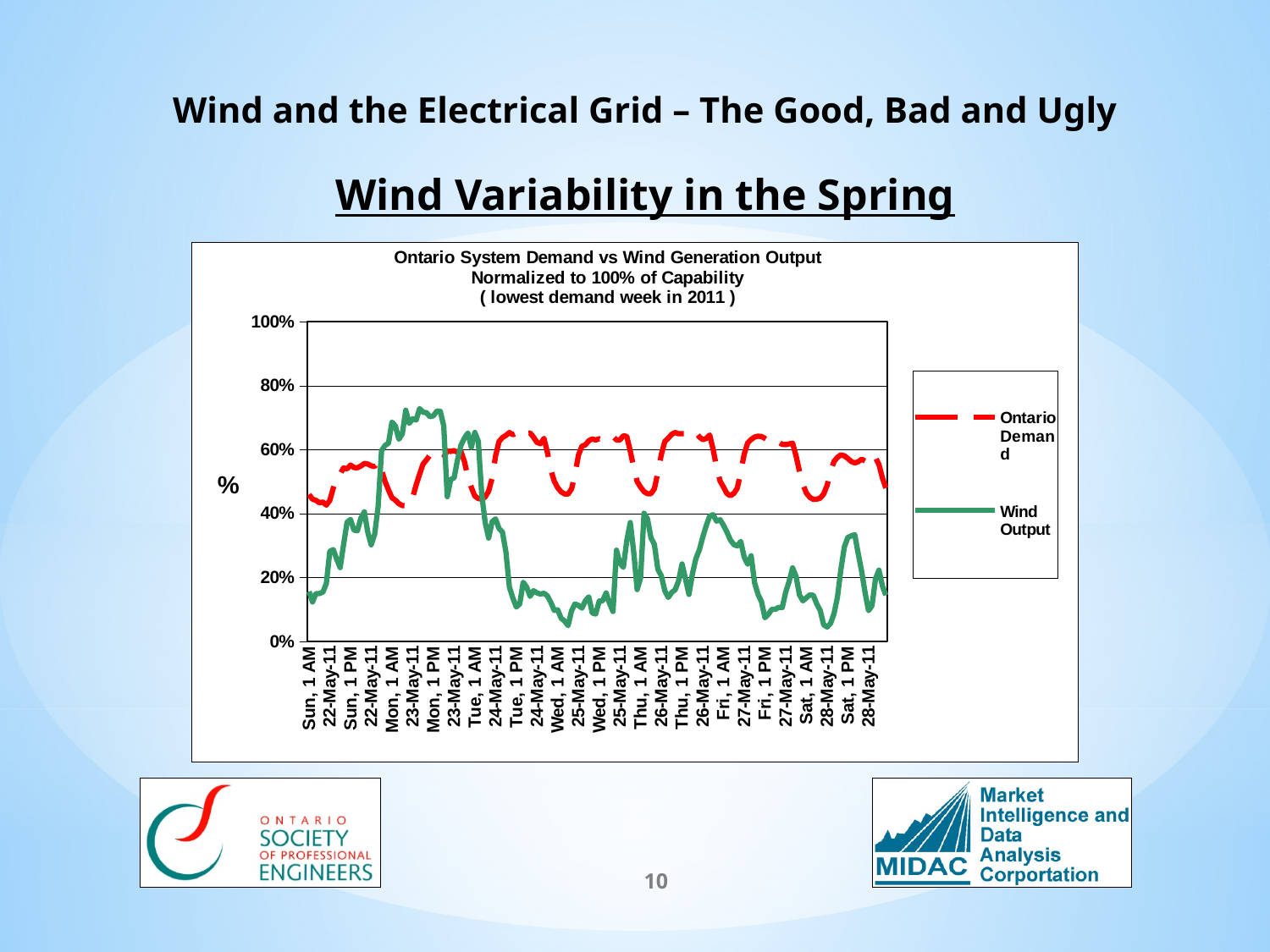
What is the first line of the chart's title? Ontario System Demand vs Wind Generation Output What is the highest value shown on the y axis? 100% What kind of chart is shown on the slide? line chart At Mon, 1 AM 23-May-11, which series has the higher value, Ontario Demand or Wind Output? Wind Output Is the highest Wind Output value on the chart greater or less than 60%? greater At Wed, 1 AM 25-May-11, which series has the higher value, Ontario Demand or Wind Output? Ontario Demand Is the Ontario Demand value at Sun, 1 AM 22-May-11 greater or less than 60%? less How many series does the chart legend list? 2 How many tick labels are shown along the x axis? 28 Which series is drawn as a red dashed line? Ontario Demand Is the highest Ontario Demand value on the chart greater or less than 80%? less